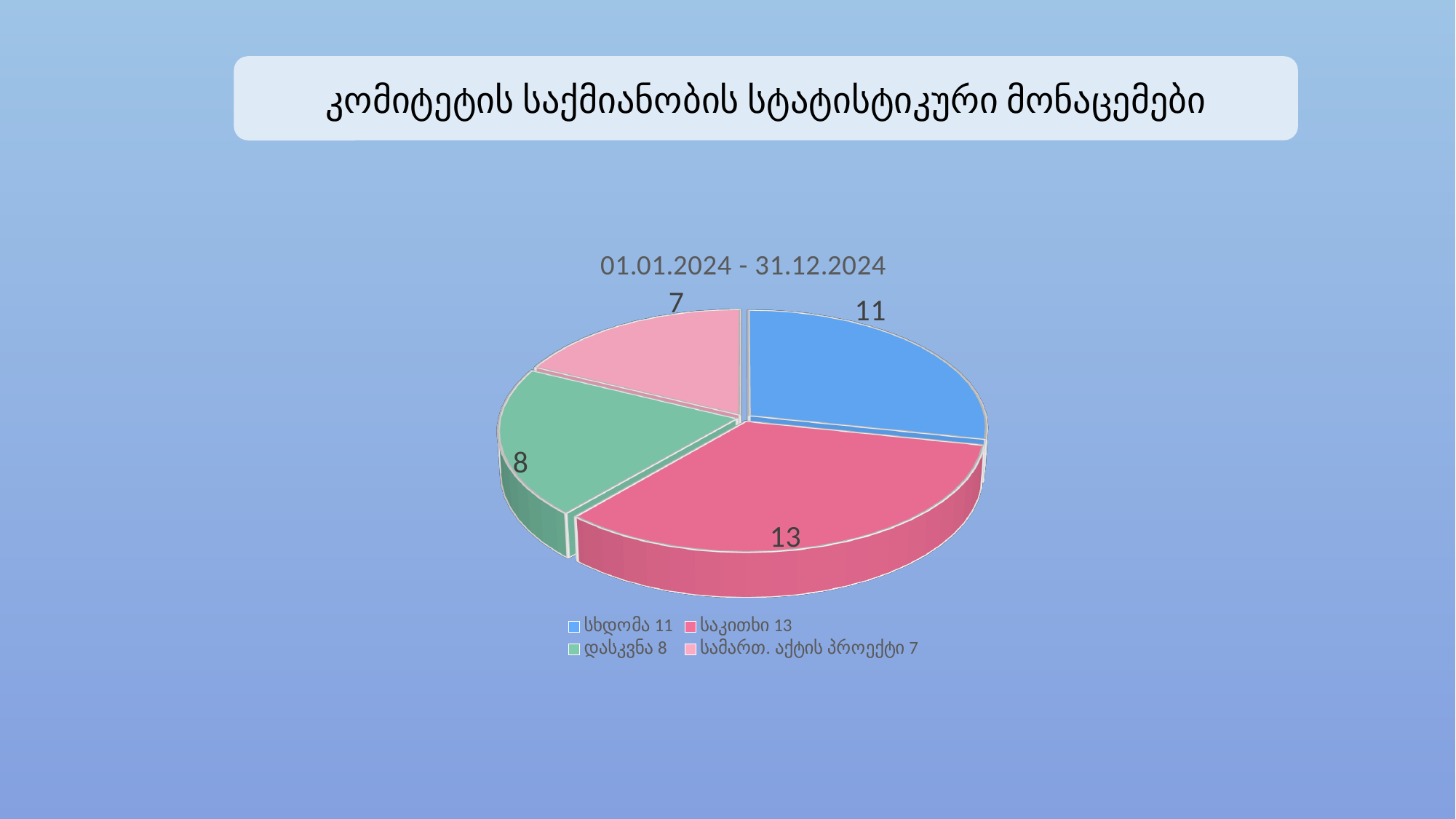
What is the difference between the values for საკითხი and სხდომა? 2 What is the value for სხდომა in the pie chart? 11 What type of chart is shown on the slide? pie chart What is the value for დასკვნა in the pie chart? 8 What is the value for სამართ. აქტის პროექტი in the pie chart? 7 Which is larger, the value for დასკვნა or the value for სამართ. აქტის პროექტი? დასკვნა Which category has the largest slice in the pie chart? საკითხი What is the value for საკითხი in the pie chart? 13 What is the total of all the values in the pie chart? 39 How many slices does the pie chart have? 4 Which category has the smallest slice in the pie chart? სამართ. აქტის პროექტი What period is given in the chart title? 01.01.2024 - 31.12.2024